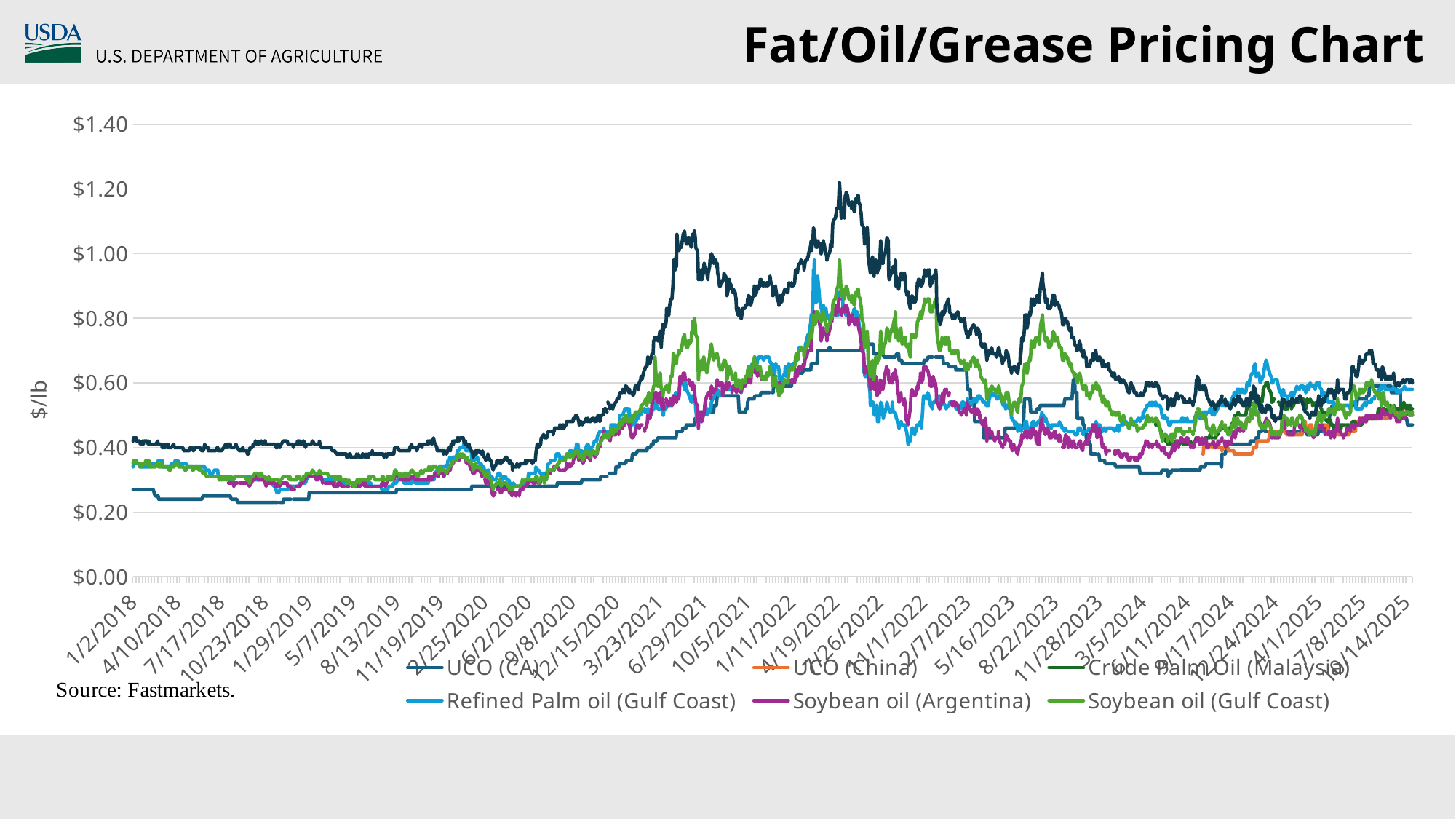
What kind of chart is shown on the slide? line chart What is the label on the y axis of the chart? $/lb Between 1/2/2018 and 4/19/2022, do the prices generally rise or fall? rise Is the highest value reached by any series on the chart greater or less than $1.00? greater How many series does the legend list? 6 At 1/2/2018, is the highest series value greater or less than $0.60? less Is the lowest value reached by any series on the chart greater or less than $0.20? greater What is the title of the chart? Fat/Oil/Grease Pricing Chart Between 4/19/2022 and 3/5/2024, do the prices generally rise or fall? fall